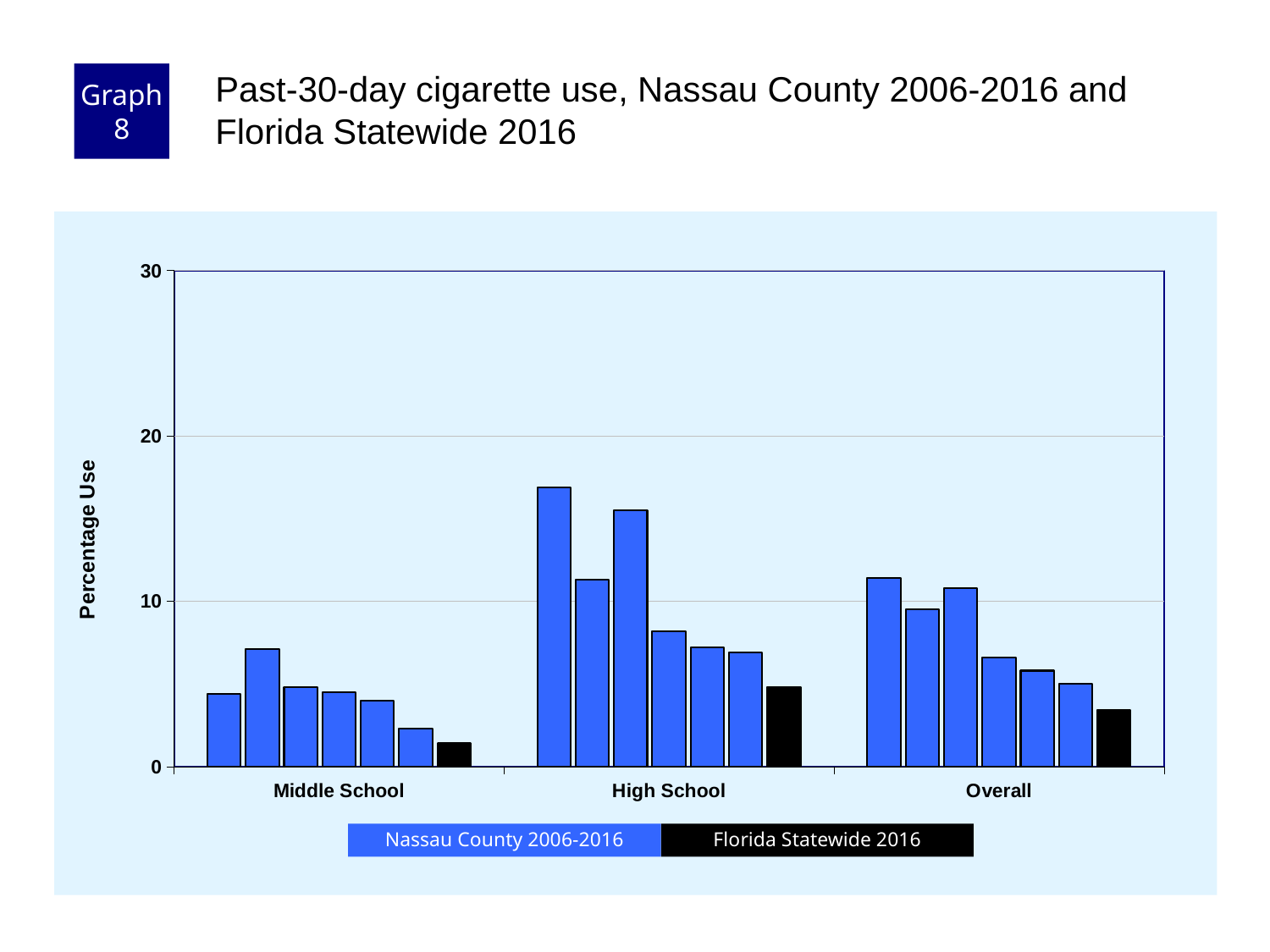
Do the Nassau County 2006-2016 bars for Overall generally rise or fall from left to right? fall How many series does the chart legend list? 2 Is the tallest Nassau County bar for High School greater or less than 10? greater Which category has the lowest bars in the chart? Middle School What is the label on the y axis of the chart? Percentage Use Which series is shown in black in the chart? Florida Statewide 2016 Is the Florida Statewide 2016 value for Middle School greater or less than 10? less Is the Florida Statewide 2016 value for High School greater or less than 10? less How many categories are shown on the x axis of the chart? 3 What kind of chart is shown on the slide? bar chart Which category has the highest bars in the chart? High School Which is larger, the Florida Statewide 2016 value for High School or for Middle School? High School